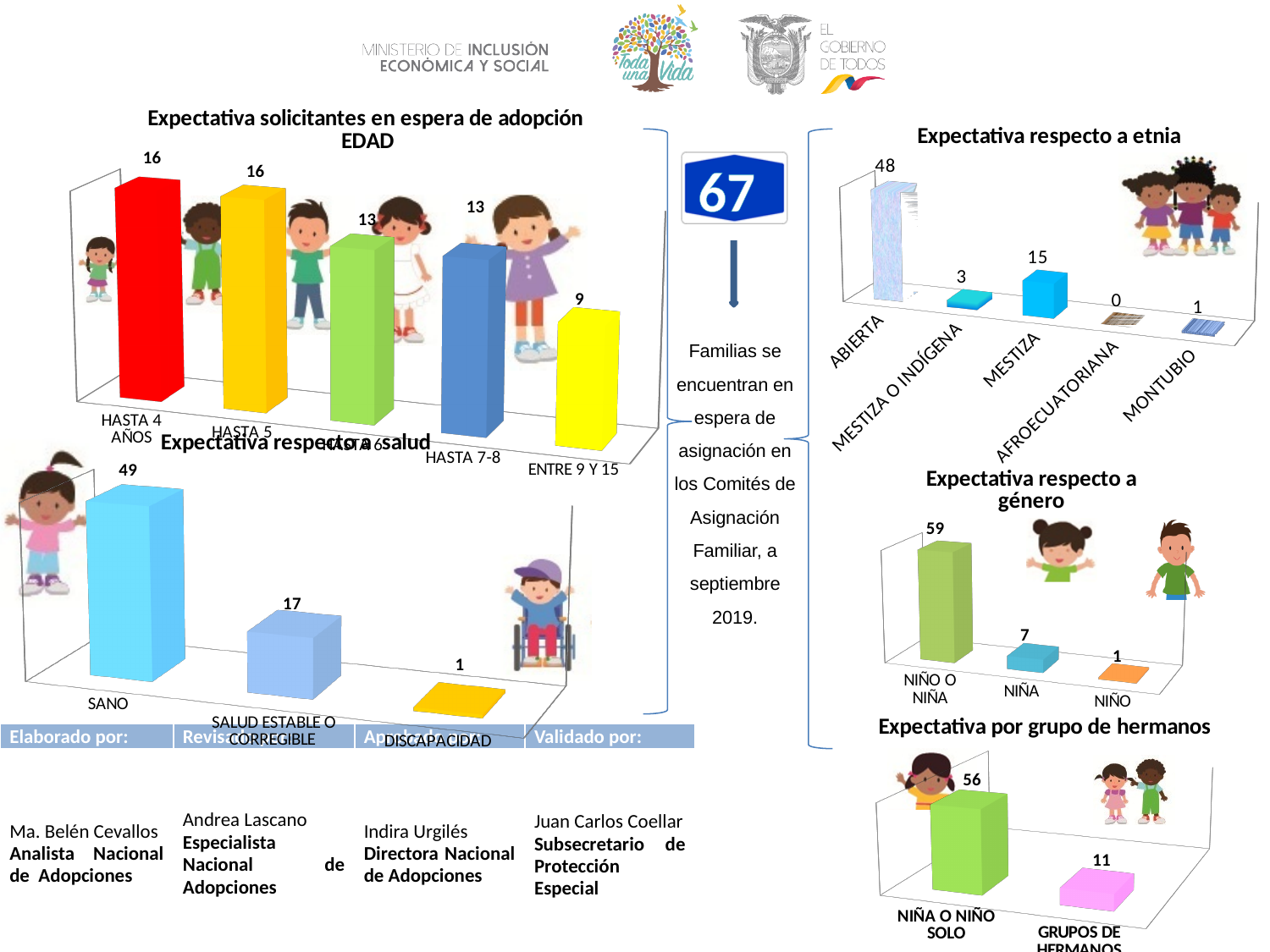
In the 'Expectativa respecto a salud' chart, what is the difference between SANO and SALUD ESTABLE O CORREGIBLE? 32 In the 'Expectativa respecto a salud' chart, what is the value for SANO? 49 In the 'Expectativa respecto a género' chart, which category has the highest value? NIÑO O NIÑA In the 'Expectativa solicitantes en espera de adopción EDAD' chart, what is the value for ENTRE 9 Y 15? 9 In the 'Expectativa respecto a etnia' chart, what is the value for MESTIZA? 15 How many categories are shown in the 'Expectativa por grupo de hermanos' chart? 2 What kind of chart is 'Expectativa respecto a salud'? bar chart In the 'Expectativa respecto a etnia' chart, which category has the lowest value? AFROECUATORIANA In the 'Expectativa respecto a género' chart, what is the value for NIÑA? 7 How many categories are shown in the 'Expectativa respecto a etnia' chart? 5 In the 'Expectativa por grupo de hermanos' chart, what is the difference between NIÑA O NIÑO SOLO and GRUPOS DE HERMANOS? 45 In the 'Expectativa solicitantes en espera de adopción EDAD' chart, which is larger: HASTA 7-8 or ENTRE 9 Y 15? HASTA 7-8